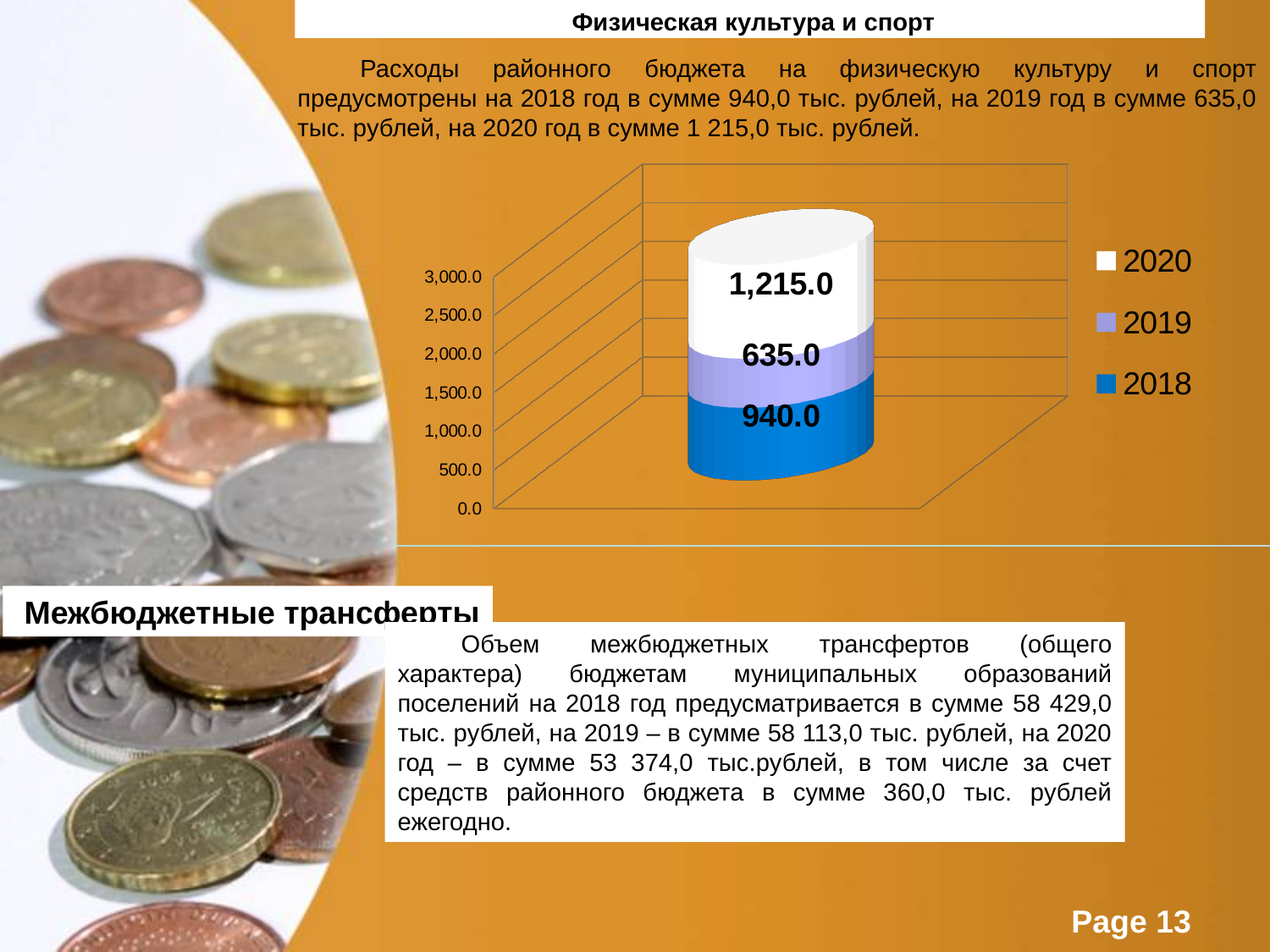
Which is larger in the chart, the value for 2019 or the value for 2020? 2020 What kind of chart is shown on the slide? Stacked bar chart What colour is the 2018 series in the chart? Blue How many series does the chart legend list? 3 Which series has the lowest value in the chart? 2019 Which series has the highest value in the chart? 2020 What is the value shown for the 2018 series in the chart? 940.0 What is the total of the stacked bar in the chart? 2,790.0 What is the difference between the 2018 value and the 2019 value in the chart? 305.0 What is the value shown for the 2019 series in the chart? 635.0 What is the difference between the 2020 value and the 2018 value in the chart? 275.0 What is the value shown for the 2020 series in the chart? 1,215.0